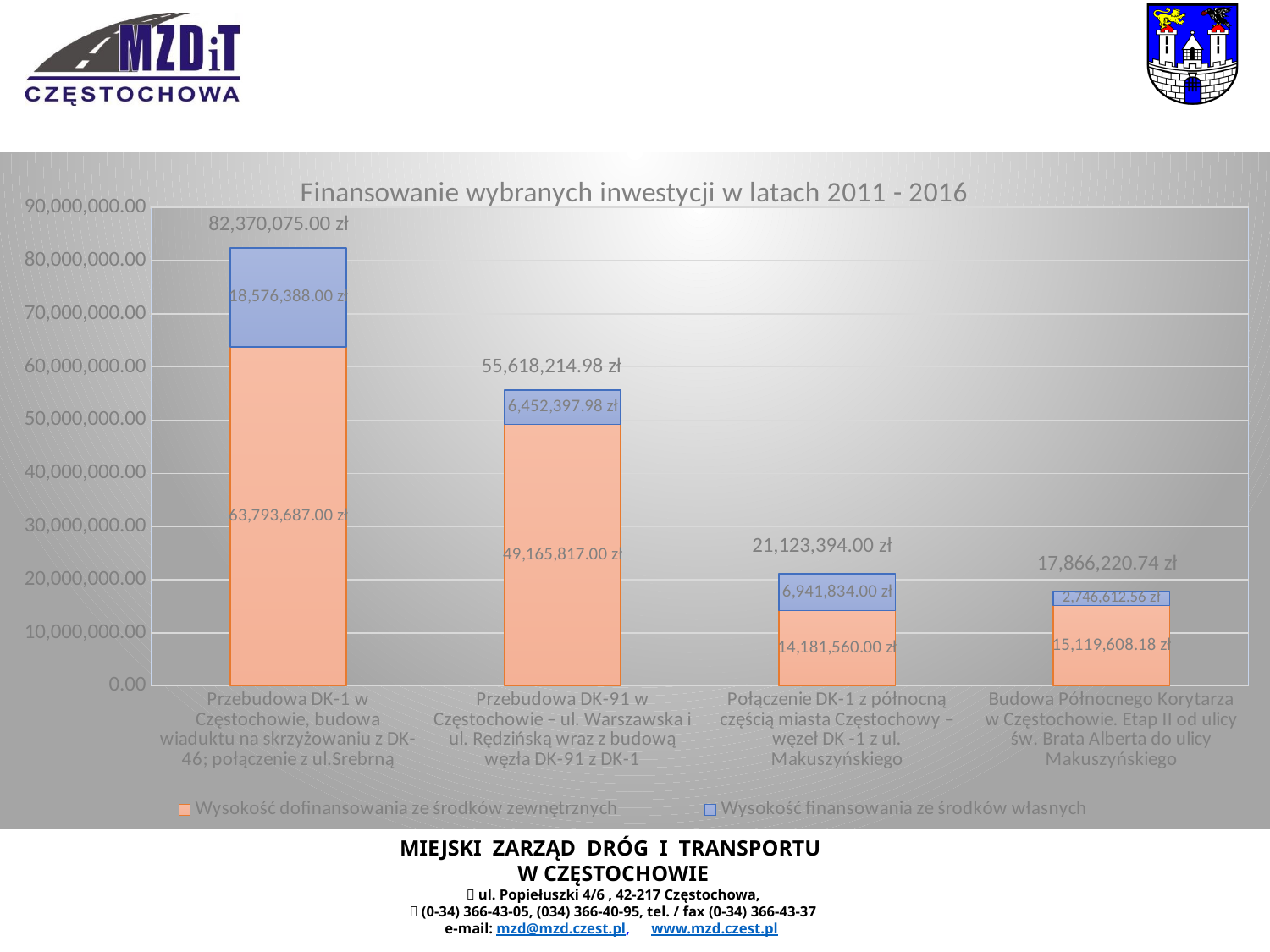
Which is larger: the 'Wysokość finansowania ze środków własnych' for 'Połączenie DK-1 z północną częścią miasta Częstochowy...' or for 'Przebudowa DK-91 w Częstochowie...'? Połączenie DK-1 z północną częścią miasta Częstochowy – węzeł DK -1 z ul. Makuszyńskiego What is the value of 'Wysokość finansowania ze środków własnych' for 'Budowa Północnego Korytarza w Częstochowie. Etap II od ulicy św. Brata Alberta do ulicy Makuszyńskiego'? 2,746,612.56 zł How many series does the legend list? 2 What is the value of 'Wysokość dofinansowania ze środków zewnętrznych' for 'Przebudowa DK-91 w Częstochowie – ul. Warszawska i ul. Rędzińską wraz z budową węzła DK-91 z DK-1'? 49,165,817.00 zł Do the total financing values rise or fall from left to right along the x axis? Fall What kind of chart is shown on the slide? Stacked bar chart What is the total shown above the bar for 'Połączenie DK-1 z północną częścią miasta Częstochowy – węzeł DK -1 z ul. Makuszyńskiego'? 21,123,394.00 zł Which investment has the highest total financing? Przebudowa DK-1 w Częstochowie, budowa wiaduktu na skrzyżowaniu z DK-46; połączenie z ul.Srebrną What is the title of the chart? Finansowanie wybranych inwestycji w latach 2011 - 2016 What is the difference between the 'Wysokość finansowania ze środków własnych' values for 'Przebudowa DK-1 w Częstochowie...' and 'Przebudowa DK-91 w Częstochowie...'? 12,123,990.02 zł Which investment has the lowest total financing? Budowa Północnego Korytarza w Częstochowie. Etap II od ulicy św. Brata Alberta do ulicy Makuszyńskiego How many investment categories are shown on the x axis? 4